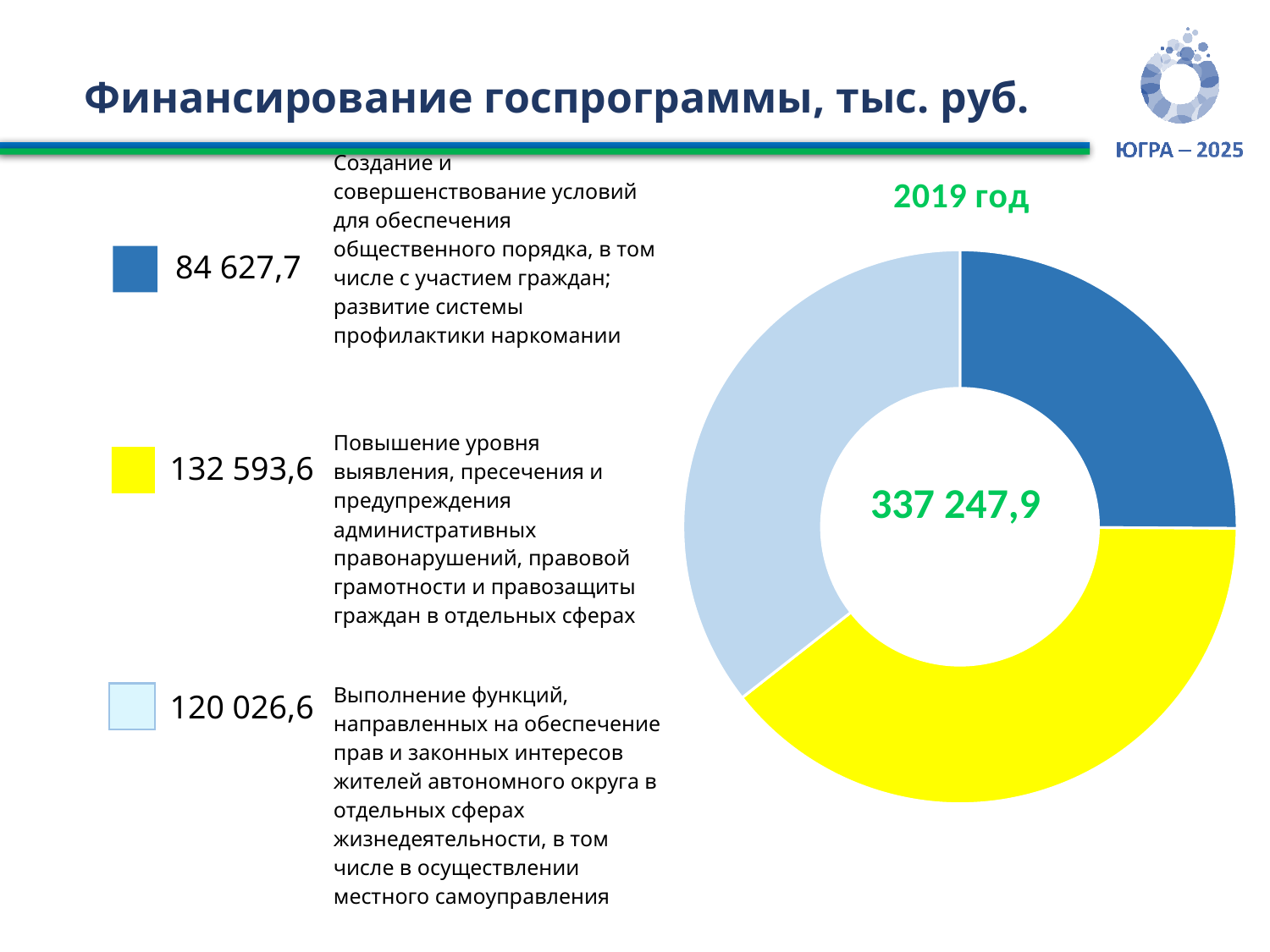
Which segment has the smallest value? Создание и совершенствование условий для обеспечения общественного порядка (84 627,7) How many segments does the donut chart have? 3 What is the value for the segment "Повышение уровня выявления, пресечения и предупреждения административных правонарушений..."? 132 593,6 Which segment has the largest value? Повышение уровня выявления, пресечения и предупреждения административных правонарушений (132 593,6) What is the value for the segment "Выполнение функций, направленных на обеспечение прав и законных интересов жителей автономного округа..."? 120 026,6 Which year does the donut chart refer to? 2019 год What is the difference between the yellow segment (132 593,6) and the dark blue segment (84 627,7)? 47 965,9 What colour is the segment with the value 132 593,6? Yellow What kind of chart is shown on the slide? Pie (donut) chart What is the total value shown in the centre of the donut chart? 337 247,9 What is the value for the segment "Создание и совершенствование условий для обеспечения общественного порядка..."? 84 627,7 Which is larger: the light blue segment (120 026,6) or the dark blue segment (84 627,7)? The light blue segment (120 026,6)